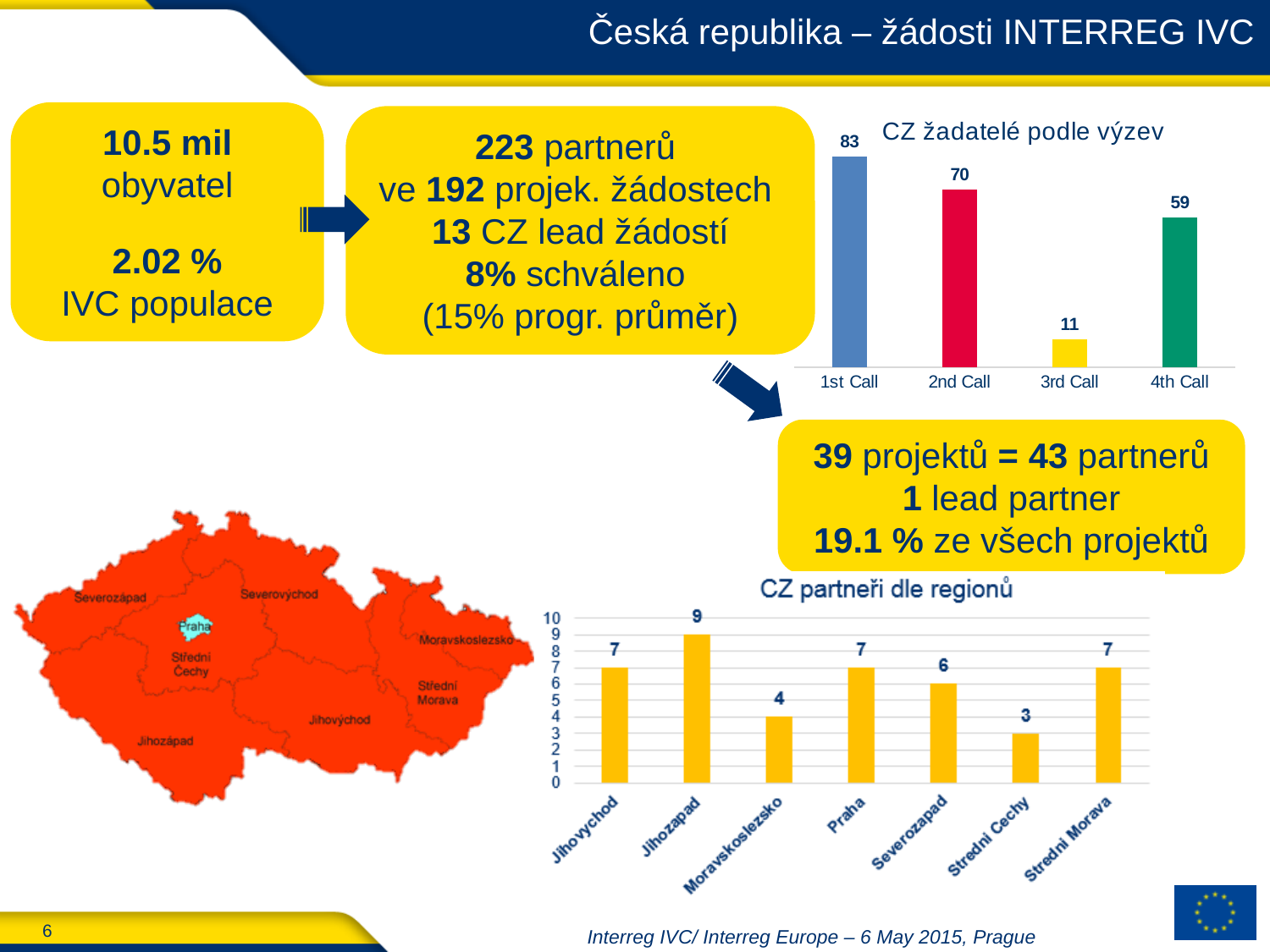
In the chart 'CZ partneři dle regionů', what is the difference between the values for Jihozapad and Stredni Cechy? 6 In the chart 'CZ partneři dle regionů', how many regions are shown? 7 In the chart 'CZ žadatelé podle výzev', what is the total of all four calls? 223 In the chart 'CZ žadatelé podle výzev', what is the value for 1st Call? 83 What kind of chart is 'CZ partneři dle regionů'? bar chart In the chart 'CZ žadatelé podle výzev', how many calls are shown? 4 In the chart 'CZ žadatelé podle výzev', which call has the lowest value? 3rd Call In the chart 'CZ partneři dle regionů', which is larger, the value for Severozapad or the value for Praha? Praha In the chart 'CZ žadatelé podle výzev', what is the difference between the values for 2nd Call and 4th Call? 11 In the chart 'CZ partneři dle regionů', what is the value for Moravskoslezsko? 4 In the chart 'CZ partneři dle regionů', which region has the highest value? Jihozapad In the chart 'CZ partneři dle regionů', which region has the lowest value? Stredni Cechy